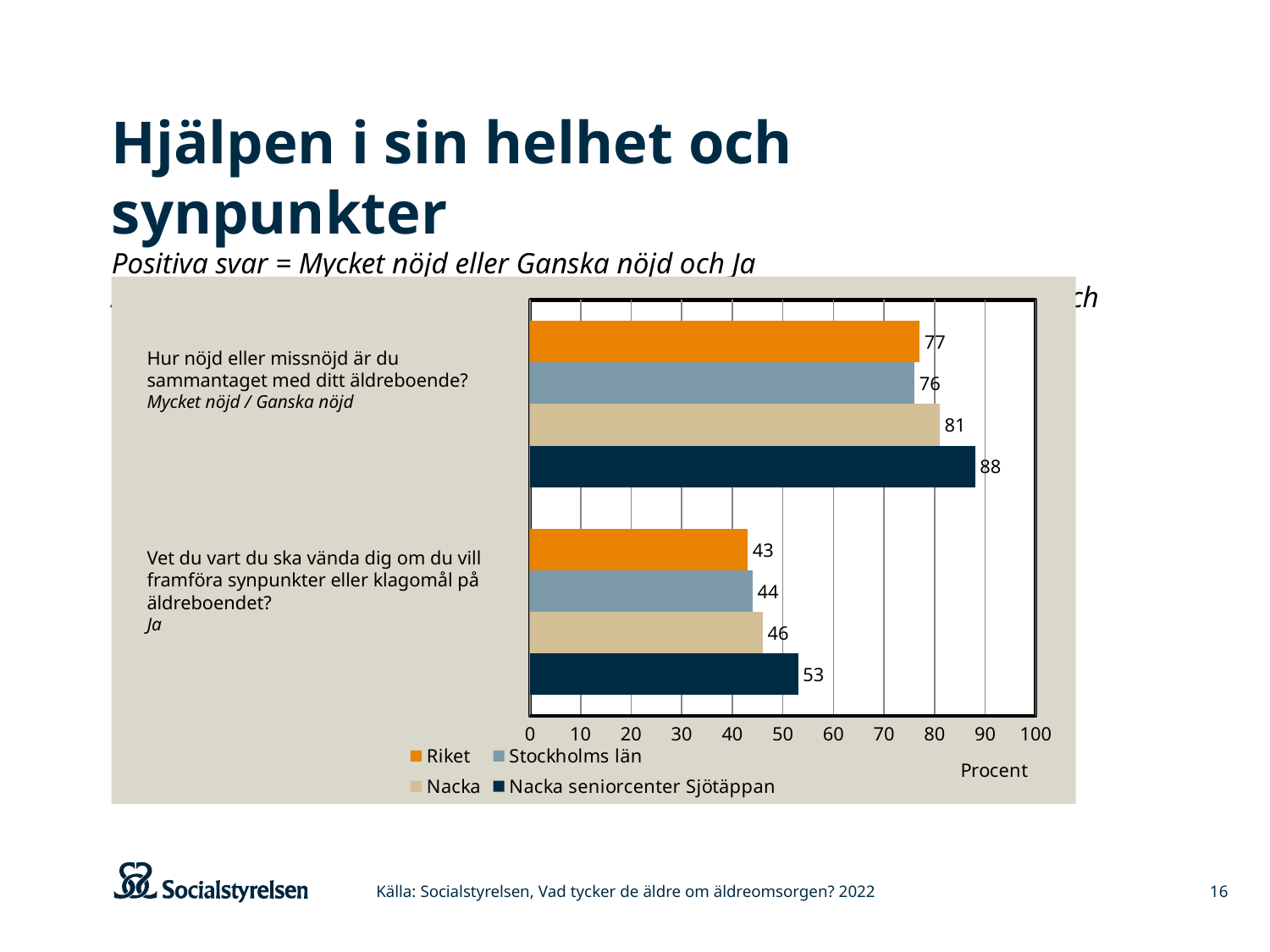
What is the value for Nacka on the question 'Vet du vart du ska vända dig om du vill framföra synpunkter eller klagomål på äldreboendet?' 46 What is the value for Nacka seniorcenter Sjötäppan on the question 'Hur nöjd eller missnöjd är du sammantaget med ditt äldreboende?' 88 What is the difference between Nacka seniorcenter Sjötäppan and Riket on the question 'Hur nöjd eller missnöjd är du sammantaget med ditt äldreboende?' 11 Which is larger: the value for Nacka or for Stockholms län on the question 'Hur nöjd eller missnöjd är du sammantaget med ditt äldreboende?' Nacka Which series has the highest value on the question 'Vet du vart du ska vända dig om du vill framföra synpunkter eller klagomål på äldreboendet?' Nacka seniorcenter Sjötäppan What is the difference between Nacka seniorcenter Sjötäppan and Nacka on the question 'Vet du vart du ska vända dig om du vill framföra synpunkter eller klagomål på äldreboendet?' 7 What is the value for Riket on the question 'Vet du vart du ska vända dig om du vill framföra synpunkter eller klagomål på äldreboendet?' 43 What kind of chart is shown on the slide? Bar chart What is the value for Stockholms län on the question 'Hur nöjd eller missnöjd är du sammantaget med ditt äldreboende?' 76 What is the label of the horizontal axis? Procent Which series has the lowest value on the question 'Hur nöjd eller missnöjd är du sammantaget med ditt äldreboende?' Stockholms län How many series does the legend list? 4